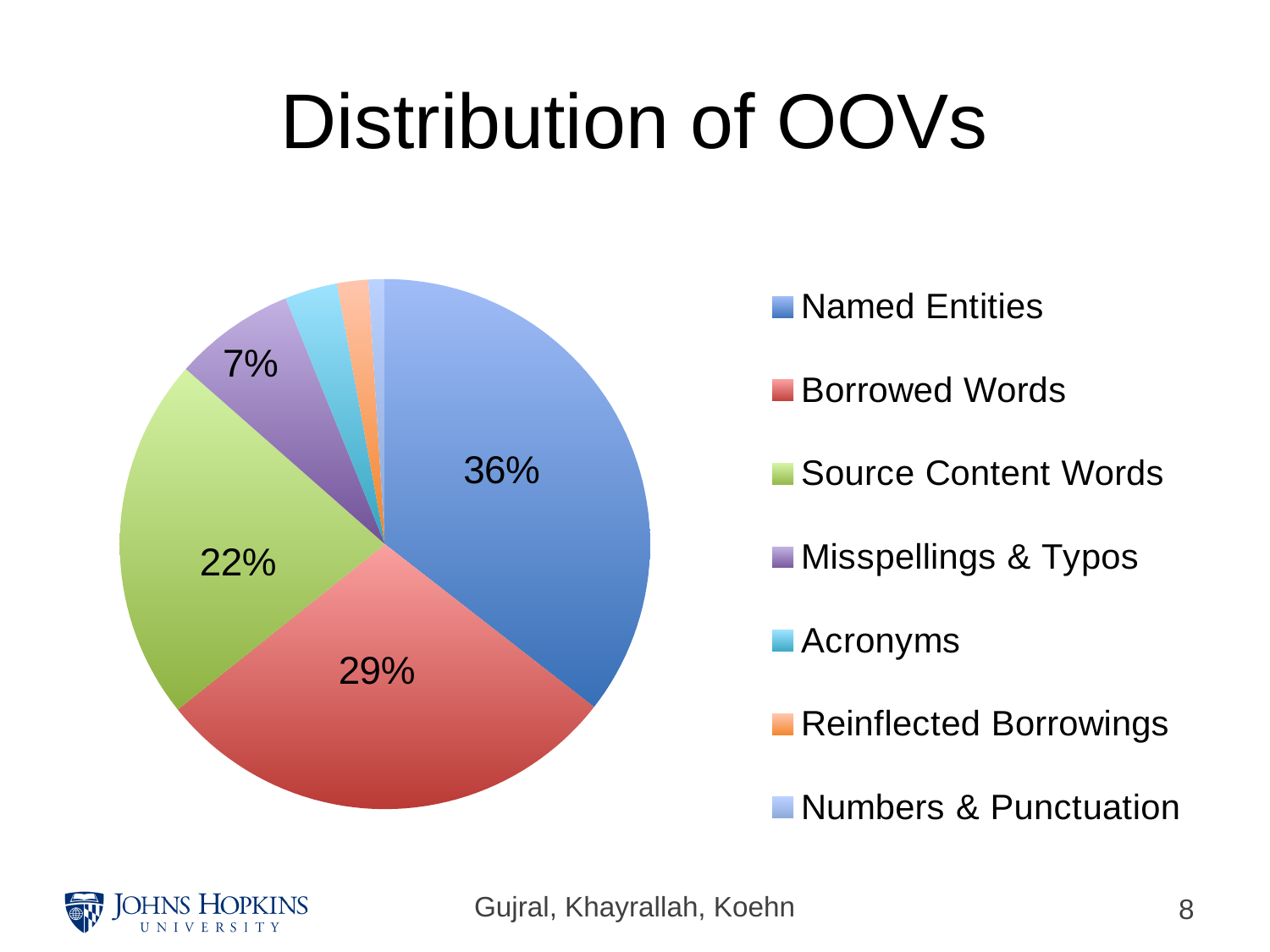
What share of the pie does Named Entities account for? 36% Which is larger, the slice for Borrowed Words or the slice for Source Content Words? Borrowed Words What percentage is shown for Borrowed Words? 29% Which category has the largest slice of the pie? Named Entities What colour is the slice for Source Content Words? Green What percentage is shown for Source Content Words? 22% What is the difference in percentage points between Named Entities and Borrowed Words? 7 What is the title of the chart? Distribution of OOVs How many categories does the legend list? 7 What percentage is shown for Misspellings & Typos? 7% Which category has the smallest slice of the pie? Numbers & Punctuation What kind of chart is shown on the slide? Pie chart